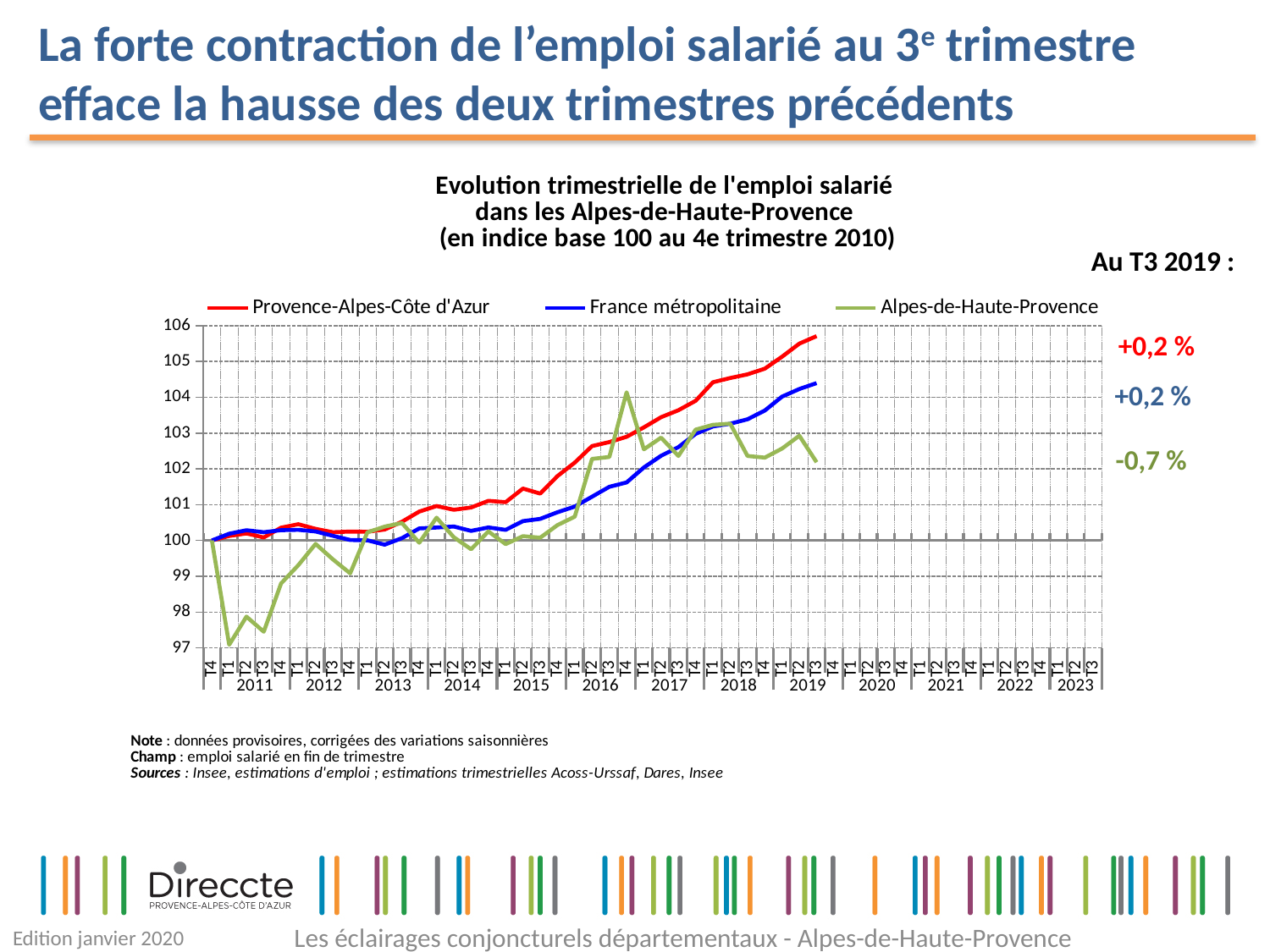
Is the value for Alpes-de-Haute-Provence at T3 2019 greater or less than 103? less At T3 2019, which series has the highest index value? Provence-Alpes-Côte d'Azur At T3 2019, which series has the lowest index value? Alpes-de-Haute-Provence What is the index value of all three series at T4 2010, the base quarter? 100 Does the Provence-Alpes-Côte d'Azur line rise or fall overall from 2011 to 2019? rise How many series does the legend list? 3 What quarterly change is annotated for Alpes-de-Haute-Provence at T3 2019? -0,7 % Is the value for Provence-Alpes-Côte d'Azur at T3 2019 greater or less than 105? greater What kind of chart is shown on the slide? line chart Is the value for France métropolitaine at T3 2019 greater or less than 105? less Which three series are listed in the chart legend? Provence-Alpes-Côte d'Azur, France métropolitaine, Alpes-de-Haute-Provence